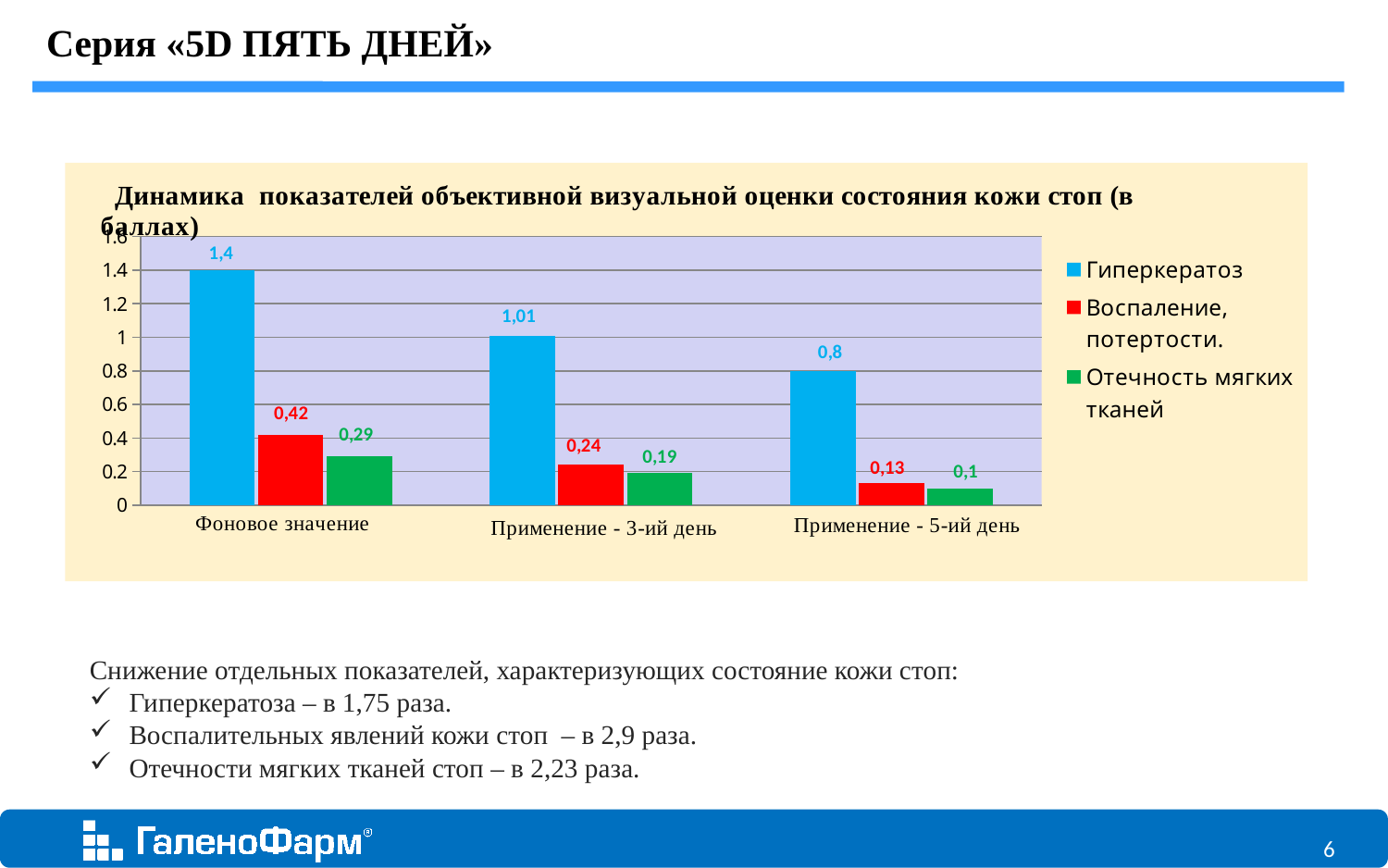
What is the value of Воспаление, потертости. for Применение - 3-ий день? 0,24 How many series does the legend list? 3 How many categories are shown on the x axis? 3 What is the value of Отечность мягких тканей for Применение - 5-ий день? 0,1 Do the Гиперкератоз values rise or fall from Фоновое значение to Применение - 5-ий день? Fall Which is larger: Воспаление, потертости. or Отечность мягких тканей for Фоновое значение? Воспаление, потертости. What kind of chart is shown on the slide? Bar chart Which category has the highest value for Гиперкератоз? Фоновое значение What is the difference between the Гиперкератоз values for Фоновое значение and Применение - 5-ий день? 0,6 Which category has the lowest value for Воспаление, потертости.? Применение - 5-ий день What is the value of Гиперкератоз for Фоновое значение? 1,4 What is the value of Гиперкератоз for Применение - 5-ий день? 0,8